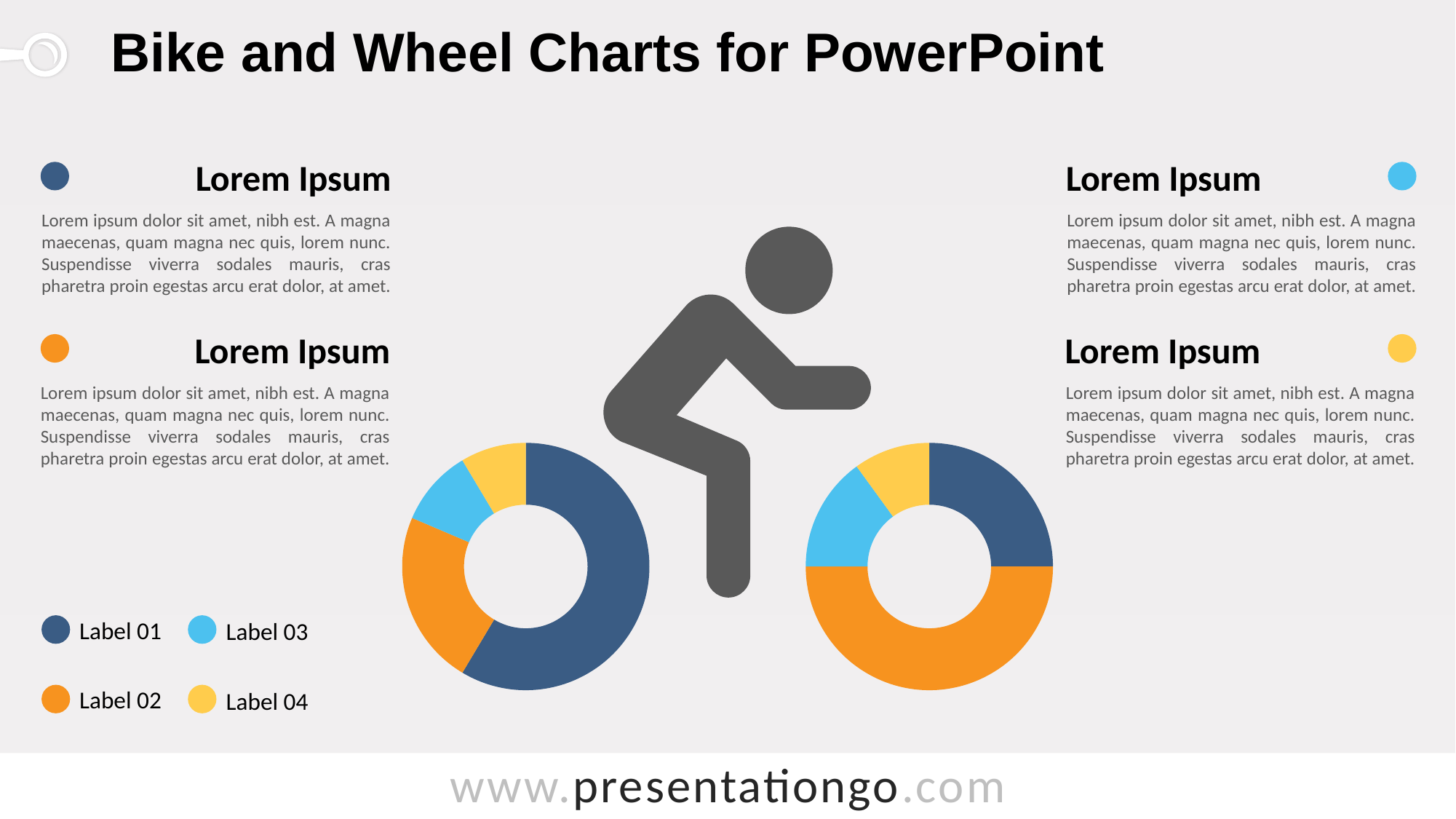
How many slices does the right wheel chart have? 4 What colour represents Label 02 in the legend? Orange How many entries does the legend list? 4 How many slices does the left wheel chart have? 4 In the right wheel chart, which slice is larger, Label 01 or Label 04? Label 01 What kind of chart is the right wheel chart? Doughnut chart In the left wheel chart, which slice is larger, Label 01 or Label 02? Label 01 In the right wheel chart, which slice is larger, Label 01 or Label 02? Label 02 In the left wheel chart, which label has the largest slice? Label 01 What kind of chart is the left wheel chart? Doughnut chart In the right wheel chart, which label has the largest slice? Label 02